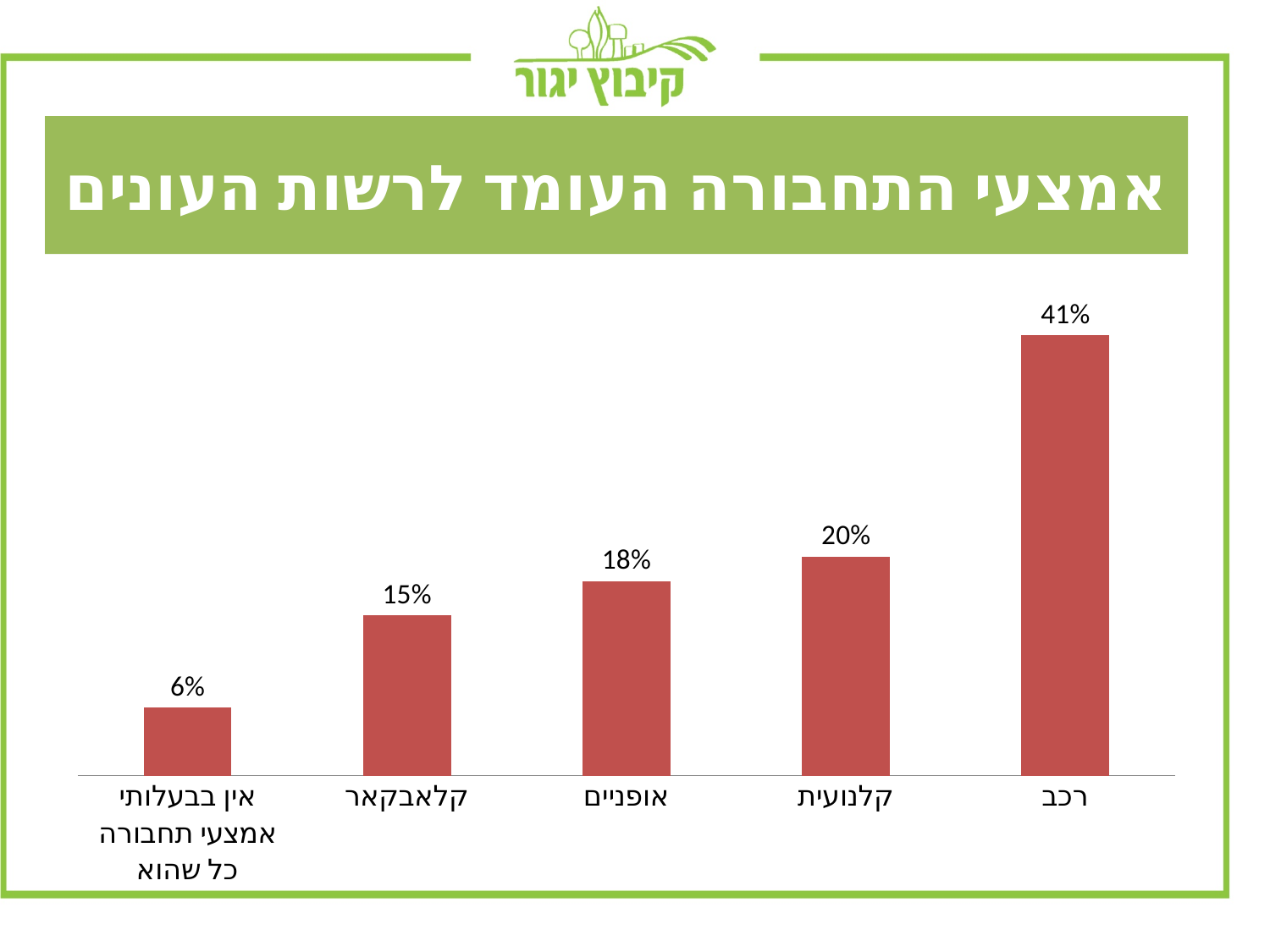
What is the value for קלנועית? 20% What is the value for אין בבעלותי אמצעי תחבורה כל שהוא? 6% What kind of chart is shown on the slide? Bar chart Do the values rise or fall from left to right along the x axis? Rise What is the value for קלאבקאר? 15% What is the value for אופניים? 18% What is the value for רכב? 41% How many categories are shown in the chart? 5 Which category has the lowest value? אין בבעלותי אמצעי תחבורה כל שהוא What is the difference between the values for רכב and קלנועית? 21% Which category has the highest value? רכב Which is larger, the value for אופניים or the value for קלאבקאר? אופניים